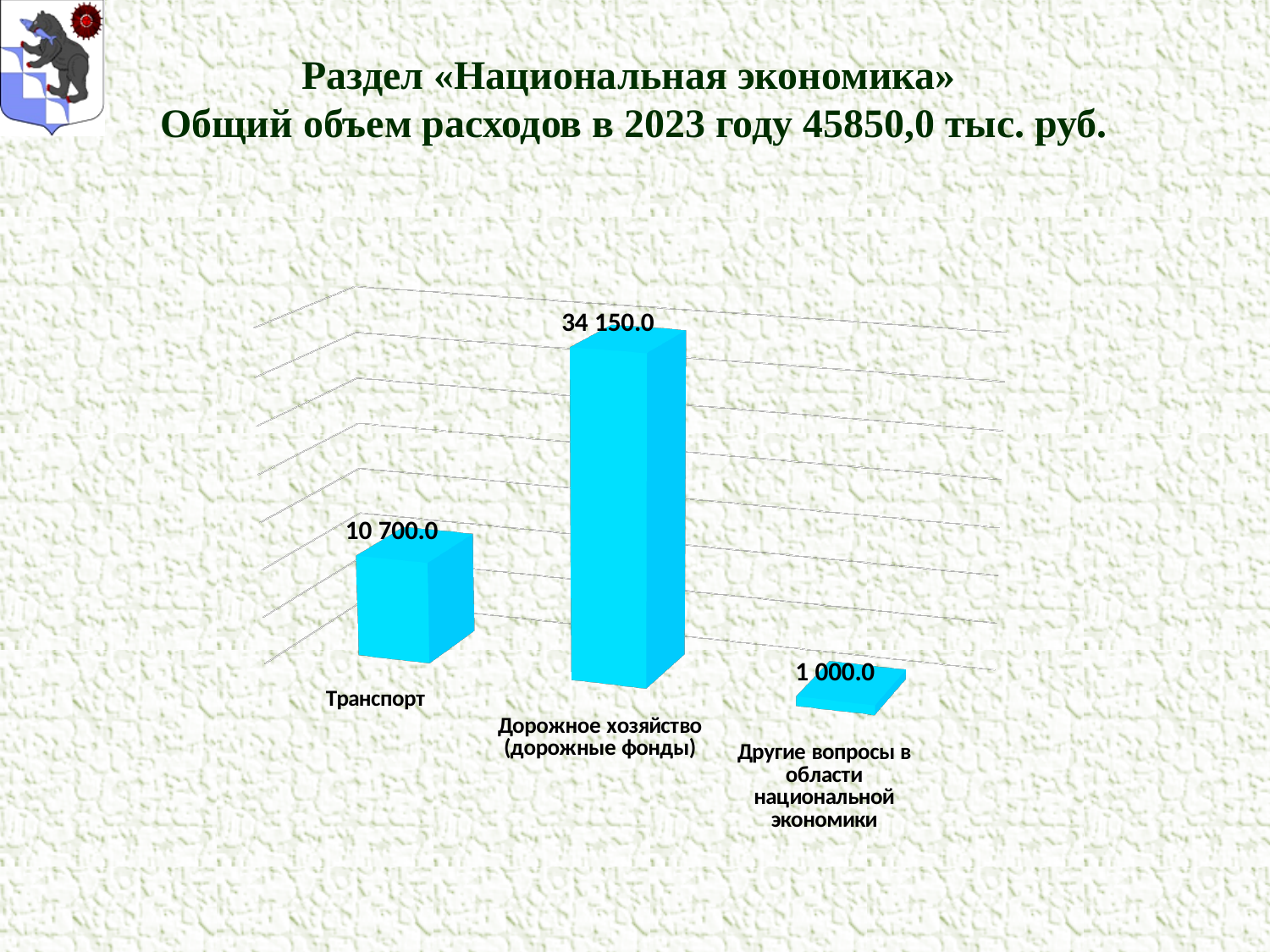
Which category has the lowest value? Другие вопросы в области национальной экономики What colour are the bars in the chart? light blue What is the difference between the values for Дорожное хозяйство (дорожные фонды) and Транспорт? 23 450.0 What is the value for Другие вопросы в области национальной экономики? 1 000.0 How many categories are shown in the chart? 3 Which category has the highest value? Дорожное хозяйство (дорожные фонды) What is the difference between the values for Транспорт and Другие вопросы в области национальной экономики? 9 700.0 What is the total expenditure for 2023 stated in the slide title? 45850,0 тыс. руб. Which is larger, the value for Транспорт or the value for Другие вопросы в области национальной экономики? Транспорт What is the value for Транспорт? 10 700.0 What is the value for Дорожное хозяйство (дорожные фонды)? 34 150.0 What kind of chart is shown on the slide? bar chart